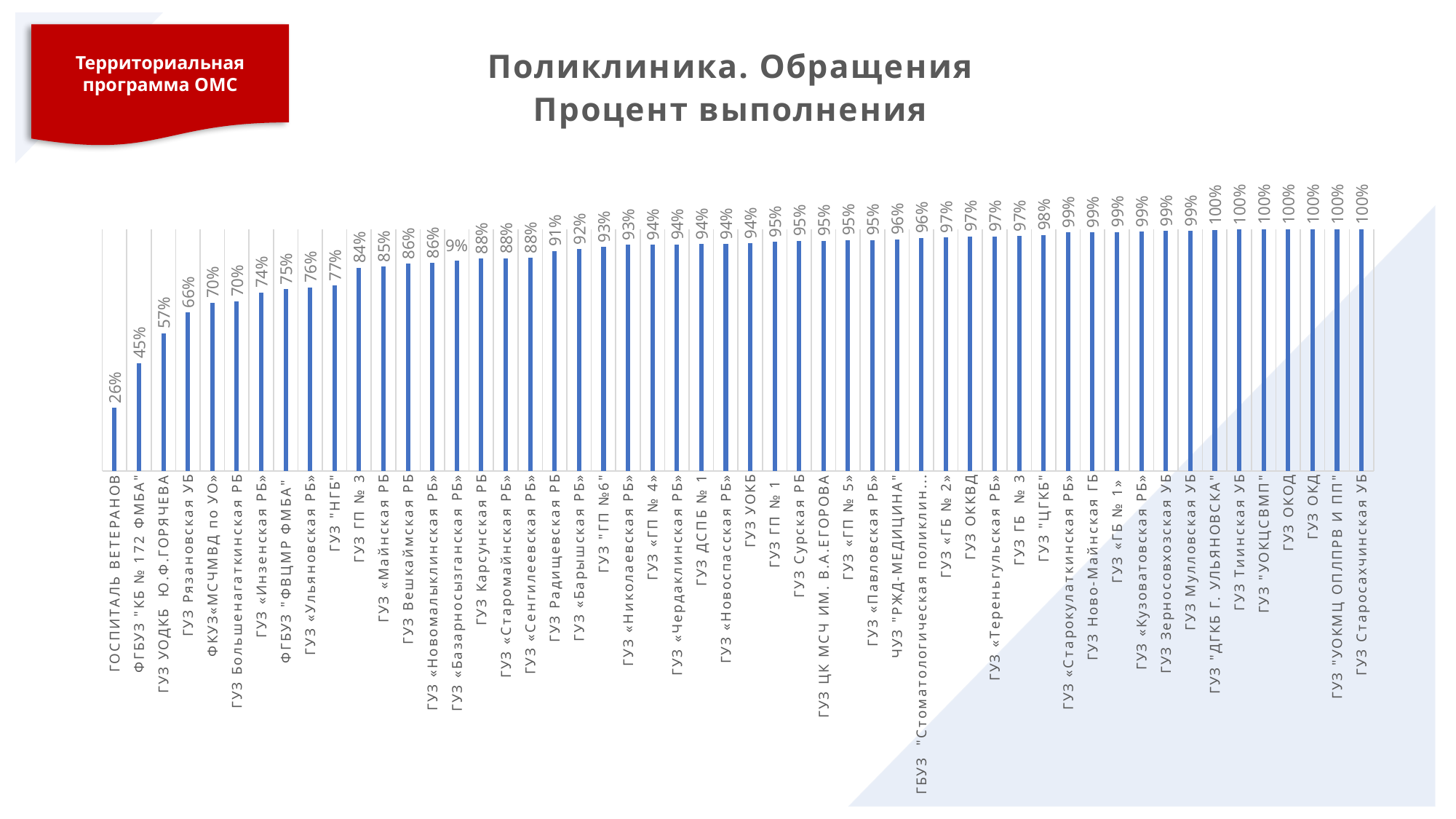
What is the difference between the values for ГУЗ УОДКБ Ю.Ф.ГОРЯЧЕВА and ГОСПИТАЛЬ ВЕТЕРАНОВ? 31% Which category has the lowest value? ГОСПИТАЛЬ ВЕТЕРАНОВ What is the value for ФГБУЗ "КБ № 172 ФМБА"? 45% What is the value for ГУЗ Рязановская УБ? 66% What is the value for ГОСПИТАЛЬ ВЕТЕРАНОВ? 26% What is the value for ГУЗ "НГБ"? 77% What is the value for ГУЗ Радищевская РБ? 91% What is the title of the chart? Поликлиника. Обращения Процент выполнения Which is larger, the value for ГУЗ «Инзенская РБ» or the value for ГУЗ ГП № 3? ГУЗ ГП № 3 What is the value for ГУЗ "ЦГКБ"? 98% What kind of chart is shown on the slide? bar chart Do the values generally rise or fall from left to right along the x axis? rise